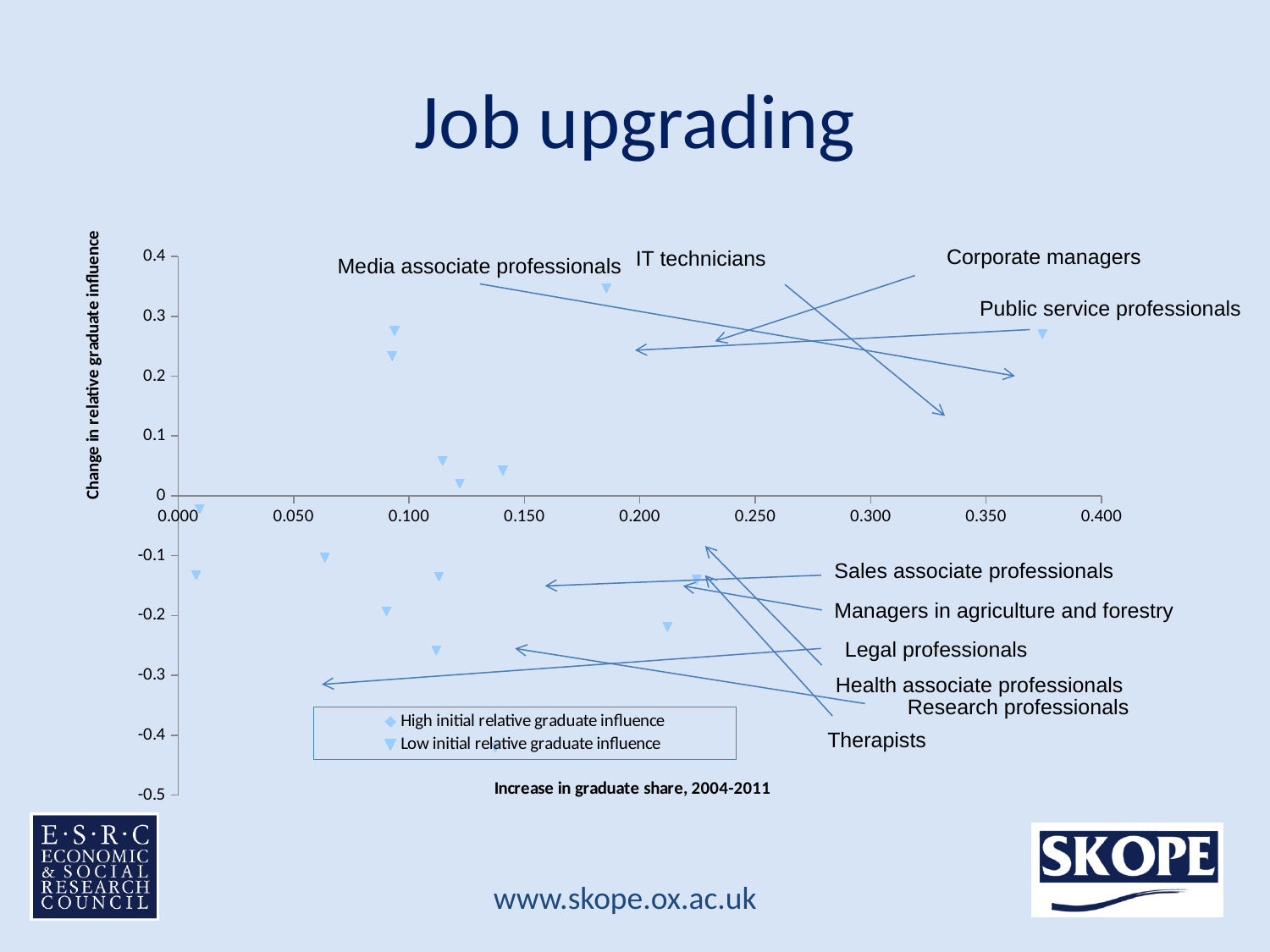
Which labelled occupation has the highest change in relative graduate influence on the chart? IT technicians Is the change in relative graduate influence for IT technicians greater or less than 0.3? greater What kind of chart is shown on the slide? scatter chart Is the increase in graduate share for IT technicians greater or less than 0.200? less Is the lowest plotted change in relative graduate influence greater or less than -0.2? less What is the title of the horizontal axis of the chart? Increase in graduate share, 2004-2011 What are the two series named in the chart legend? High initial relative graduate influence; Low initial relative graduate influence How many series does the chart legend list? 2